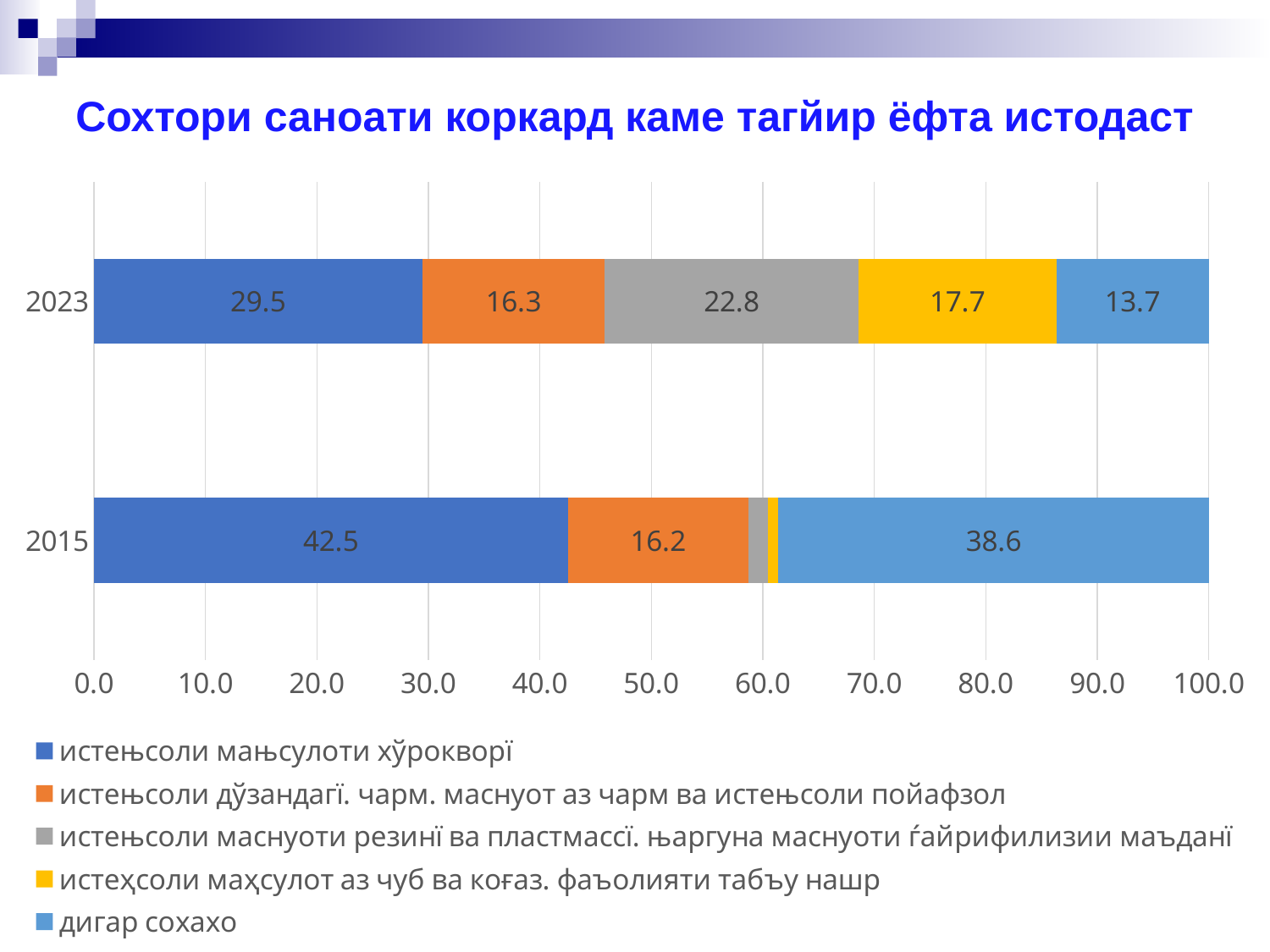
By how much did the value for истењсоли мањсулоти хўрокворї fall from 2015 to 2023? 13.0 What is the value for истеҳсоли маҳсулот аз чуб ва коғаз. фаъолияти табъу нашр in 2023? 17.7 What is the value for истењсоли мањсулоти хўрокворї in 2023? 29.5 Which series has the largest segment in the 2023 bar? истењсоли мањсулоти хўрокворї How many years (bars) are shown in the chart? 2 Is the value for истењсоли маснуоти резинї ва пластмассї. њаргуна маснуоти ѓайрифилизии маъданї in 2015 greater or less than 10.0? less How many series does the legend list? 5 What kind of chart is shown on the slide? Stacked bar chart Which year has the larger value for дигар сохахо, 2015 or 2023? 2015 What is the value for истењсоли мањсулоти хўрокворї in 2015? 42.5 What is the value for дигар сохахо in 2015? 38.6 What is the value for истењсоли маснуоти резинї ва пластмассї. њаргуна маснуоти ѓайрифилизии маъданї in 2023? 22.8